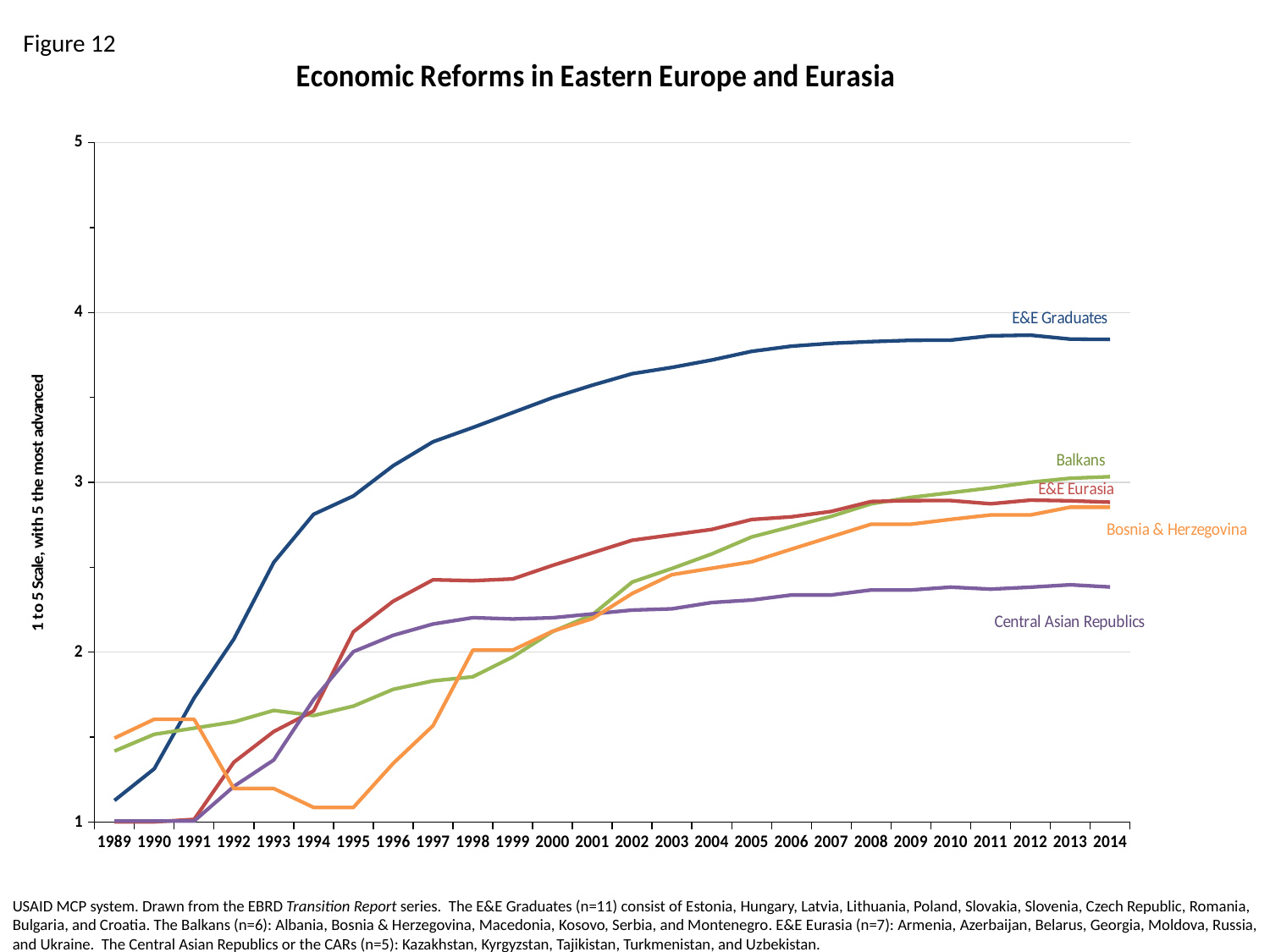
Which series has the highest value in 2014? E&E Graduates Which series has the lowest value in 2014? Central Asian Republics Is the value for E&E Graduates in 2014 greater or less than 4? less How many years are shown along the x axis? 26 Is the value for Bosnia & Herzegovina in 1994 greater or less than 2? less In 1989, which is larger: the value for E&E Graduates or the value for Bosnia & Herzegovina? Bosnia & Herzegovina What kind of chart is shown on the slide? line chart In 2014, which is larger: the value for Balkans or the value for Central Asian Republics? Balkans Is the value for Central Asian Republics in 2014 greater or less than 2? greater How many series are plotted on the chart? 5 What is the title of the chart? Economic Reforms in Eastern Europe and Eurasia Does the E&E Graduates line generally rise or fall from 1989 to 2014? rise